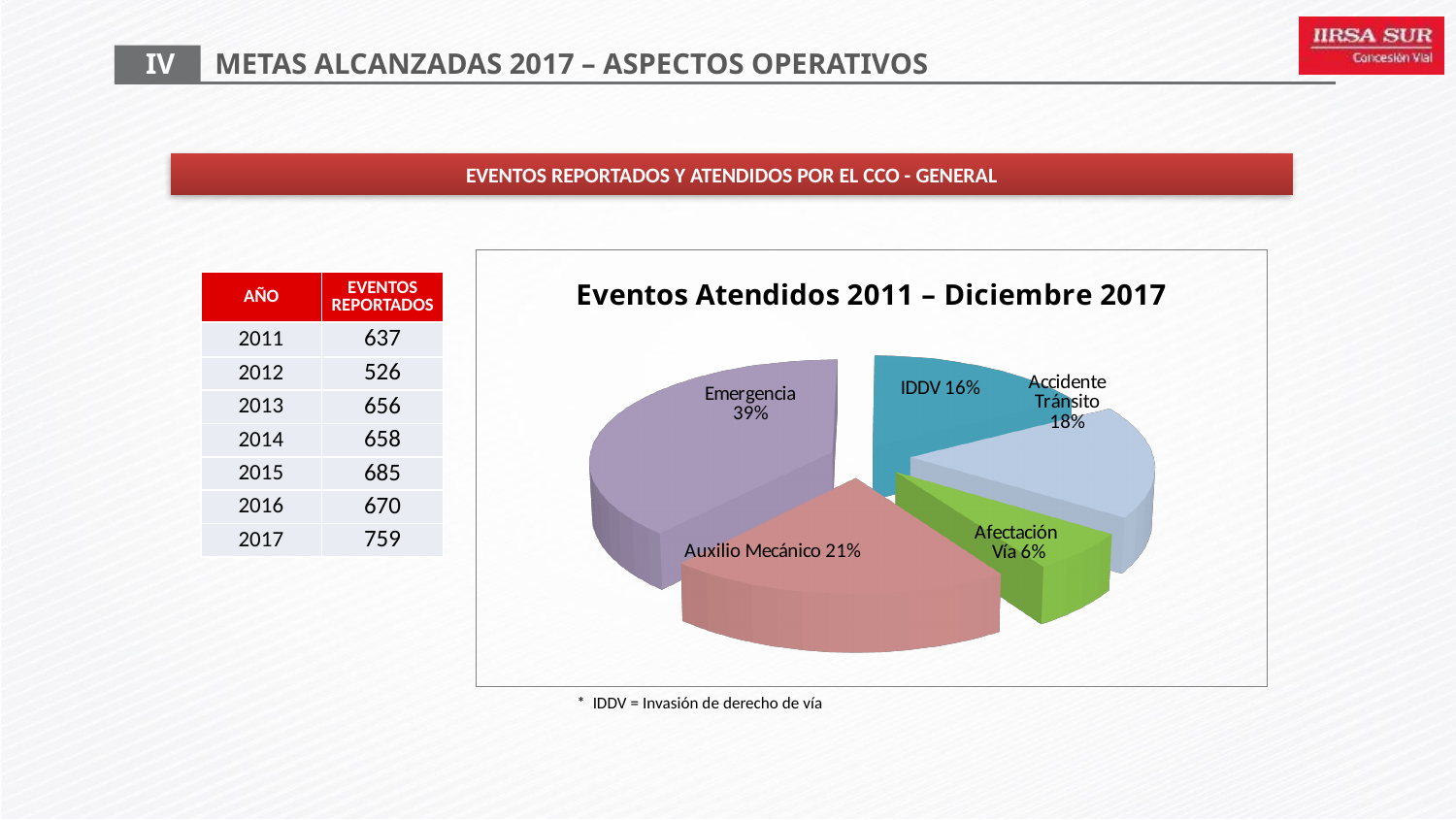
What share of the pie does Emergencia represent? 39% Which category has the smallest slice of the pie? Afectación Vía Which is larger, the share for Accidente Tránsito or the share for IDDV? Accidente Tránsito What is the title of the pie chart? Eventos Atendidos 2011 – Diciembre 2017 What share of the pie does Afectación Vía represent? 6% What kind of chart is shown on the slide? pie chart Which category has the largest slice of the pie? Emergencia What is the difference in percentage points between Emergencia and Auxilio Mecánico? 18 What share of the pie does Accidente Tránsito represent? 18% How many slices does the pie chart have? 5